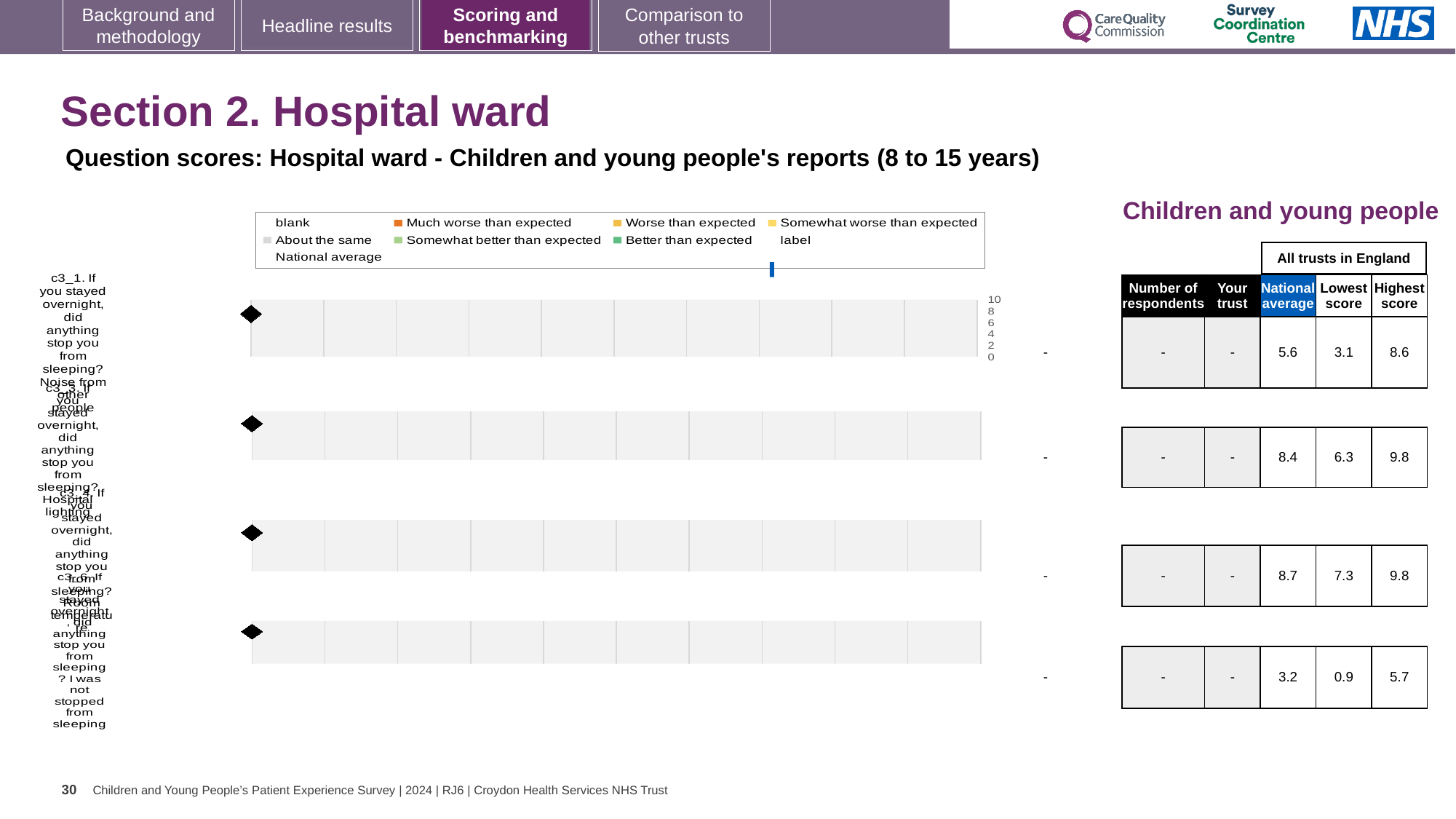
In the table next to the chart, what value is shown in the 'Your trust' column for each question row? - What kind of chart is shown on the slide? bar chart In the table next to the chart, which question row has the lowest national average? c3_6 (I was not stopped from sleeping) Which legend entry is shown with an orange marker? Much worse than expected In the table next to the chart, what is the national average for the fourth question row (c3_6, I was not stopped from sleeping)? 3.2 How many question rows (categories) does the chart show? 4 In the table next to the chart, which question row has the highest national average? c3_4 (Room temperature) In the table next to the chart, what is the difference between the highest score and the lowest score for the first question row (c3_1)? 5.5 In the table next to the chart, what is the national average for the first question row (c3_1, noise from other people)? 5.6 What is the maximum value shown on the chart's score axis? 10 In the table next to the chart, what is the highest score for the second question row (c3_3, hospital lighting)? 9.8 In the table next to the chart, what is the lowest score for the third question row (c3_4, room temperature)? 7.3